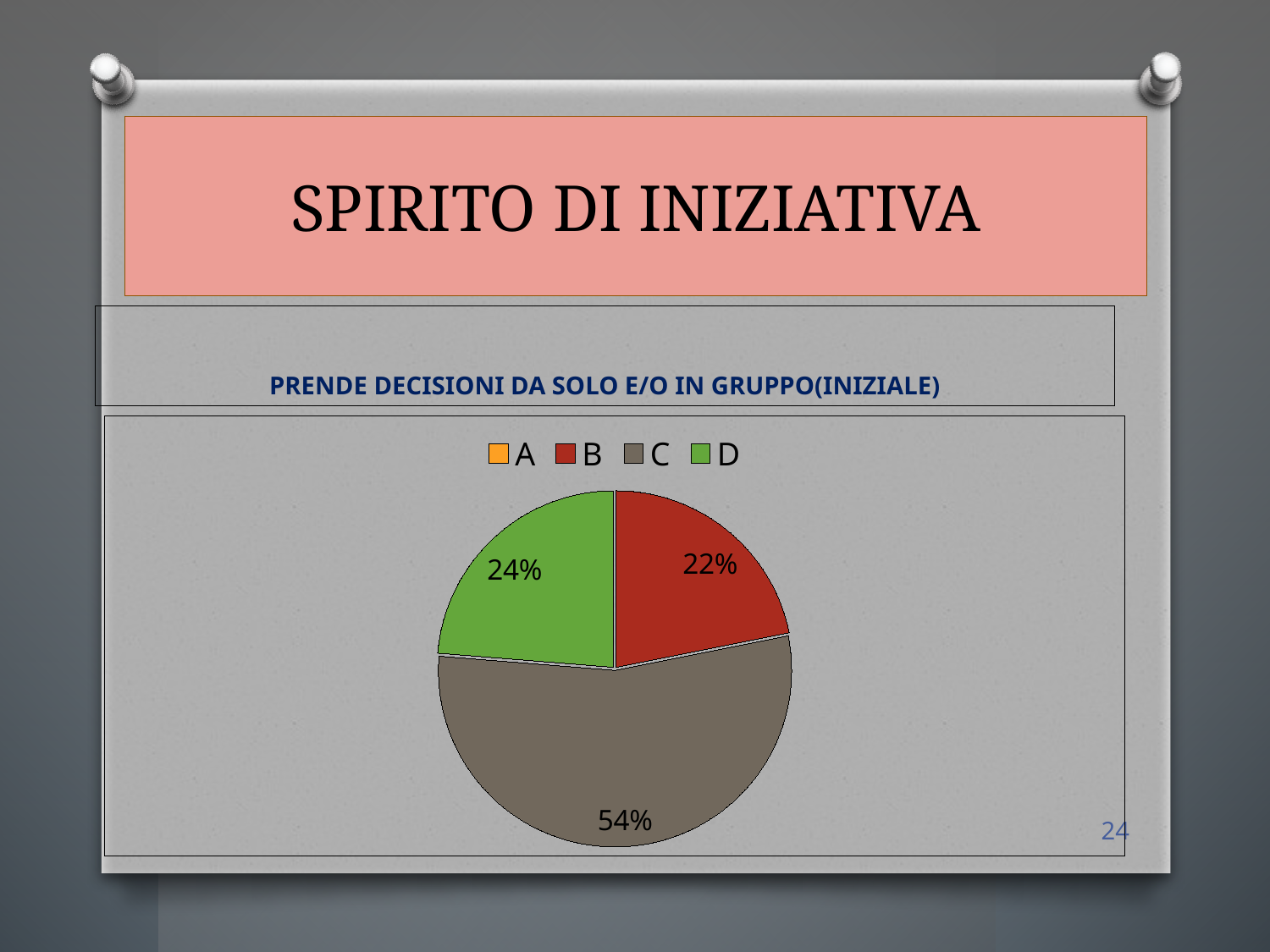
What is the difference in percentage points between slice D and slice B? 2 How many entries does the legend of the pie chart list? 4 Which category has the largest slice in the pie chart? C Which is larger in the pie chart, slice B or slice D? D What is the title of the chart on the slide? PRENDE DECISIONI DA SOLO E/O IN GRUPPO(INIZIALE) What colour is used for category C in the pie chart? Grey What percentage does slice C represent in the pie chart? 54% What is the difference in percentage points between slice C and slice B? 32 What percentage does slice D represent in the pie chart? 24% What kind of chart is shown on the slide? Pie chart What percentage does slice B represent in the pie chart? 22% How many slices have a percentage label printed on the pie chart? 3